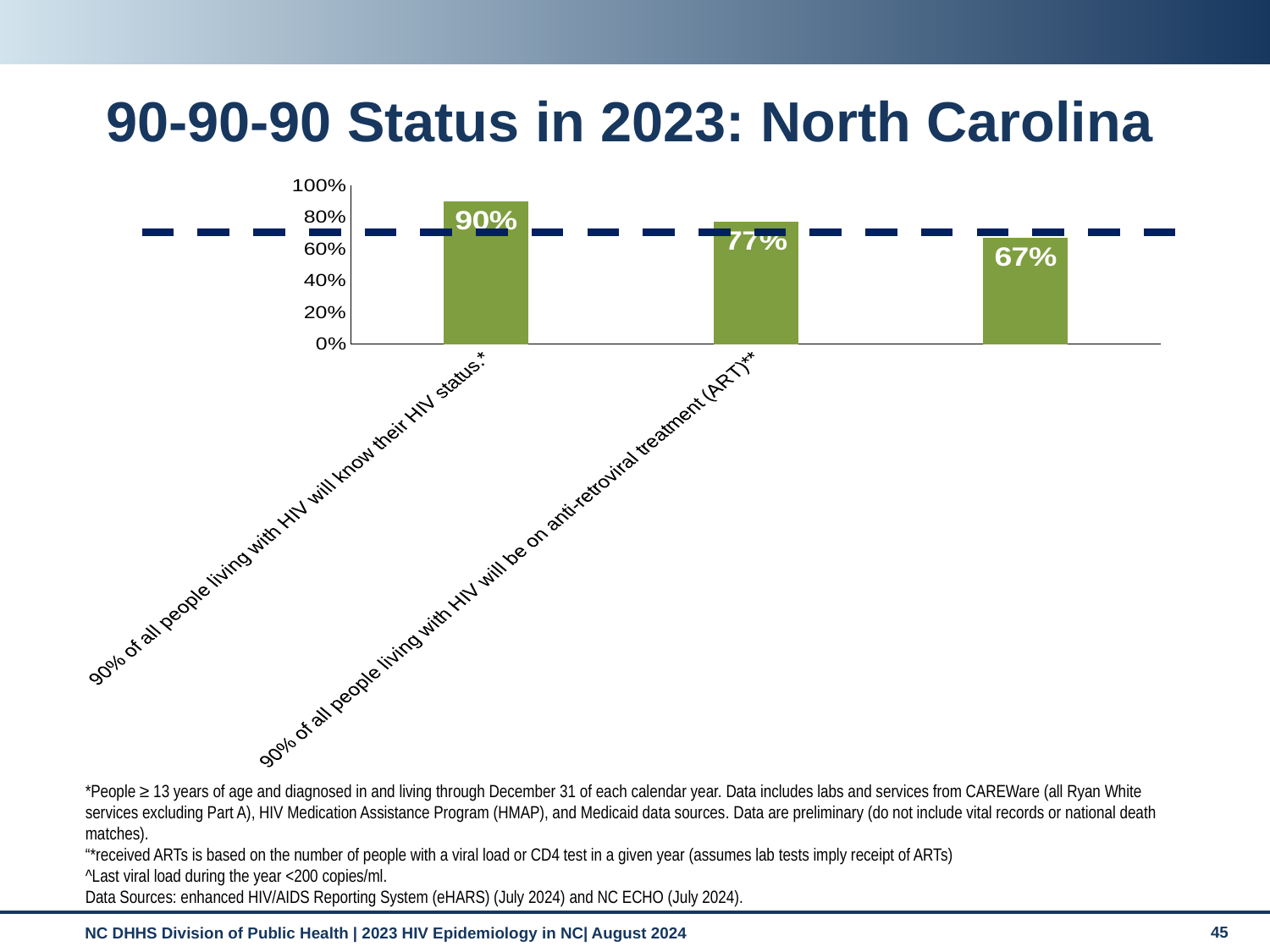
What is the difference between the second bar (77%) and the third bar (67%)? 10% Which is larger: the value for knowing HIV status or the value for being on anti-retroviral treatment (ART)? Knowing HIV status How many bars are plotted in the chart? 3 What kind of chart is shown on the slide? Bar chart Do the bar values rise or fall from left to right across the chart? Fall What value is shown on the rightmost (third) bar of the chart? 67% What value is shown for the bar labelled "90% of all people living with HIV will know their HIV status"? 90% What is the value of the lowest bar in the chart? 67% Is the value for the rightmost bar greater or less than 80%? less What is the difference between the first bar (90%) and the second bar (77%)? 13% What value is shown for the bar labelled "90% of all people living with HIV will be on anti-retroviral treatment (ART)"? 77% Which bar has the highest value? 90% of all people living with HIV will know their HIV status